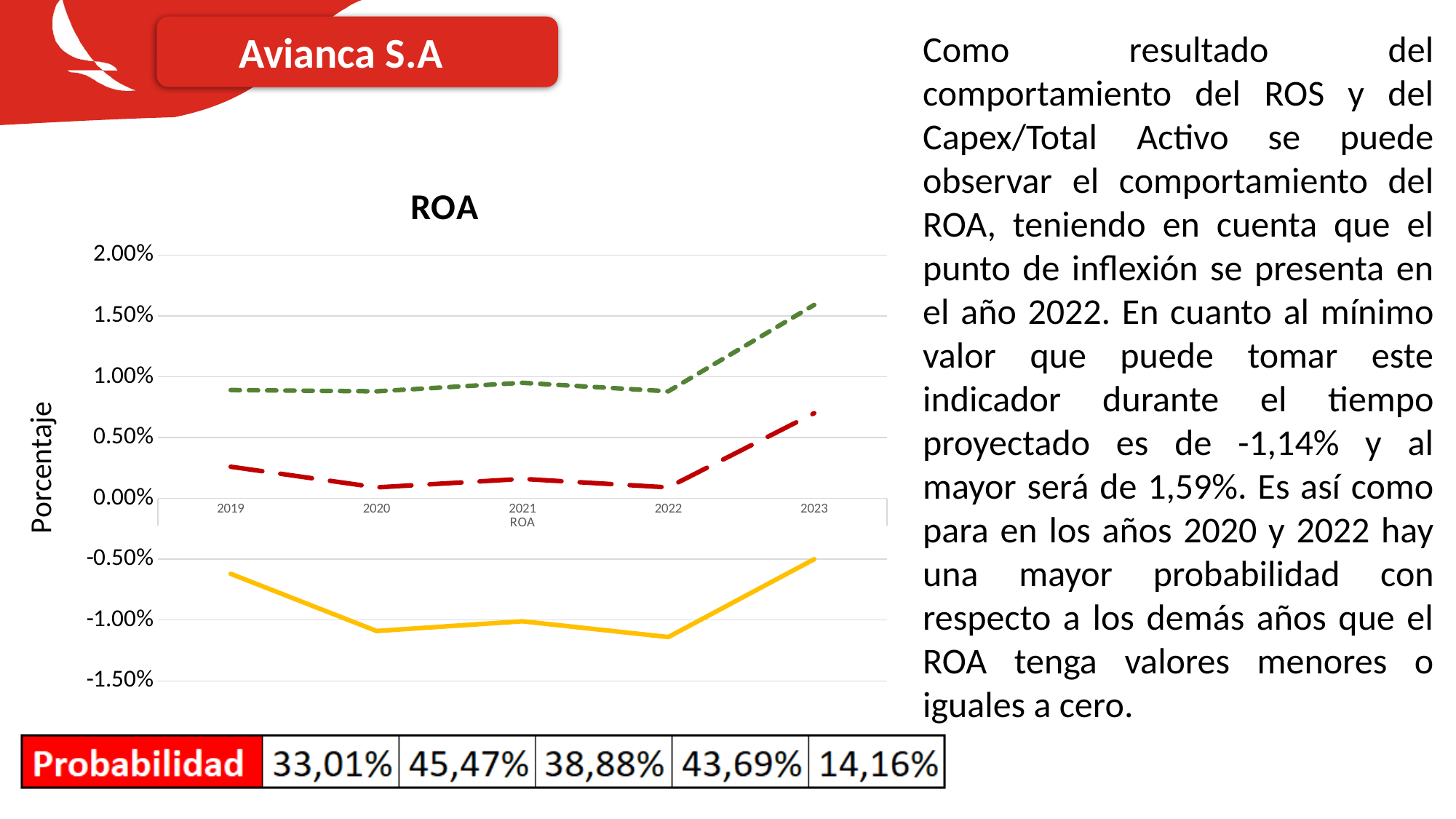
Is the value of the green dashed line in 2019 greater or less than 0.50%? greater What is the title of the chart? ROA What is the label on the vertical axis of the ROA chart? Porcentaje Is the value of the green dashed line in 2023 greater or less than 1.00%? greater In 2019, which line has the higher value, the green dashed line or the yellow solid line? green dashed line Is the value of the red dashed line in 2020 greater or less than 0.50%? less How many years are shown on the x axis of the ROA chart? 5 Does the yellow solid line rise or fall from 2022 to 2023? rise How many lines are plotted on the ROA chart? 3 What kind of chart is the ROA chart? line chart In which year does the green dashed line reach its highest value? 2023